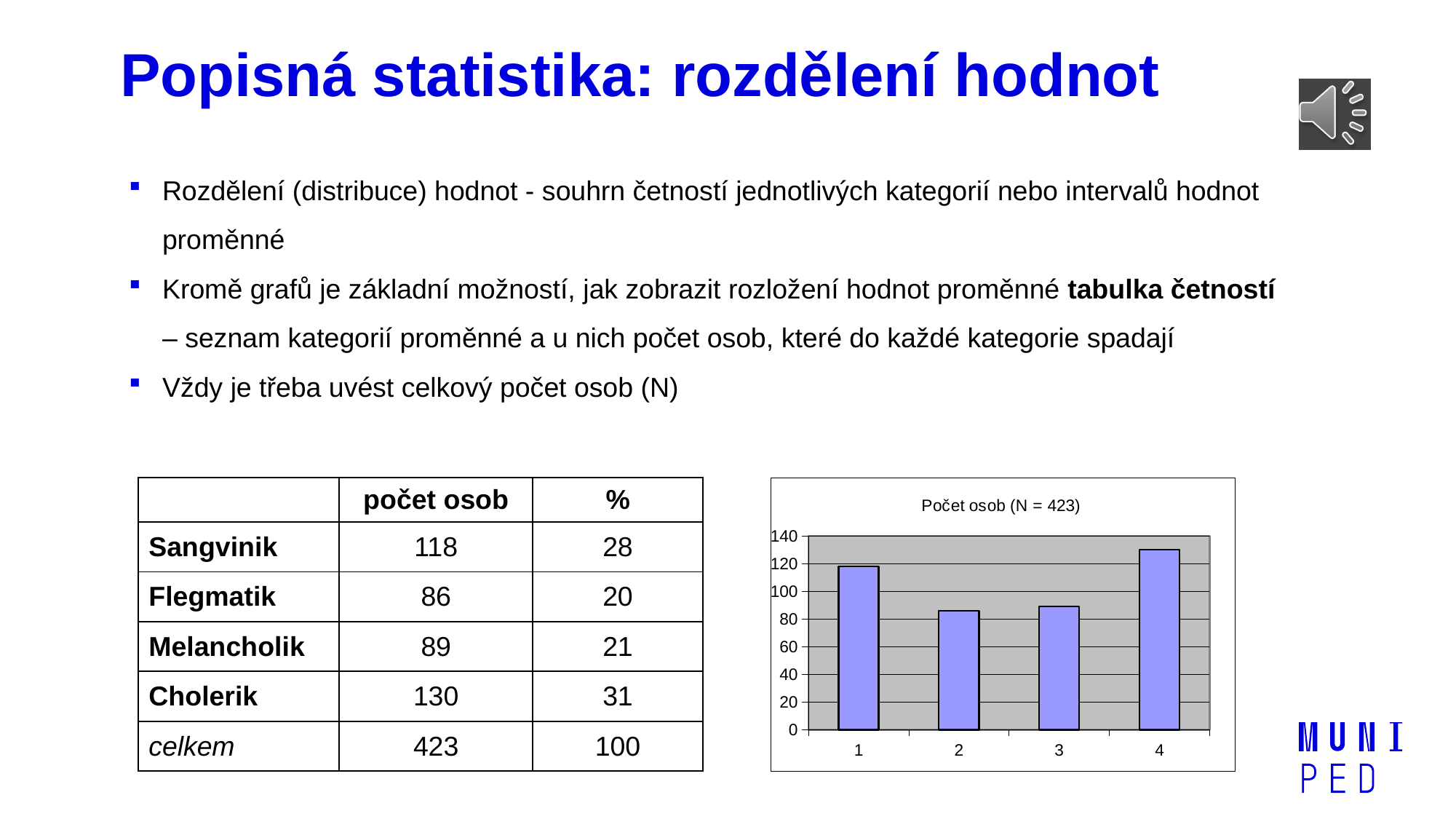
Which is larger in the chart, the value for category 1 or category 2? category 1 Is the value for category 1 greater or less than 100? greater Is the value for category 2 greater or less than 100? less Which category has the highest bar in the chart? 4 How many categories are plotted on the x axis of the chart? 4 Which is larger in the chart, the value for category 3 or category 4? category 4 What kind of chart is shown on the slide? bar chart What is the title of the chart? Počet osob (N = 423) Is the value for category 4 greater or less than 120? greater What is the highest tick value shown on the y axis of the chart? 140